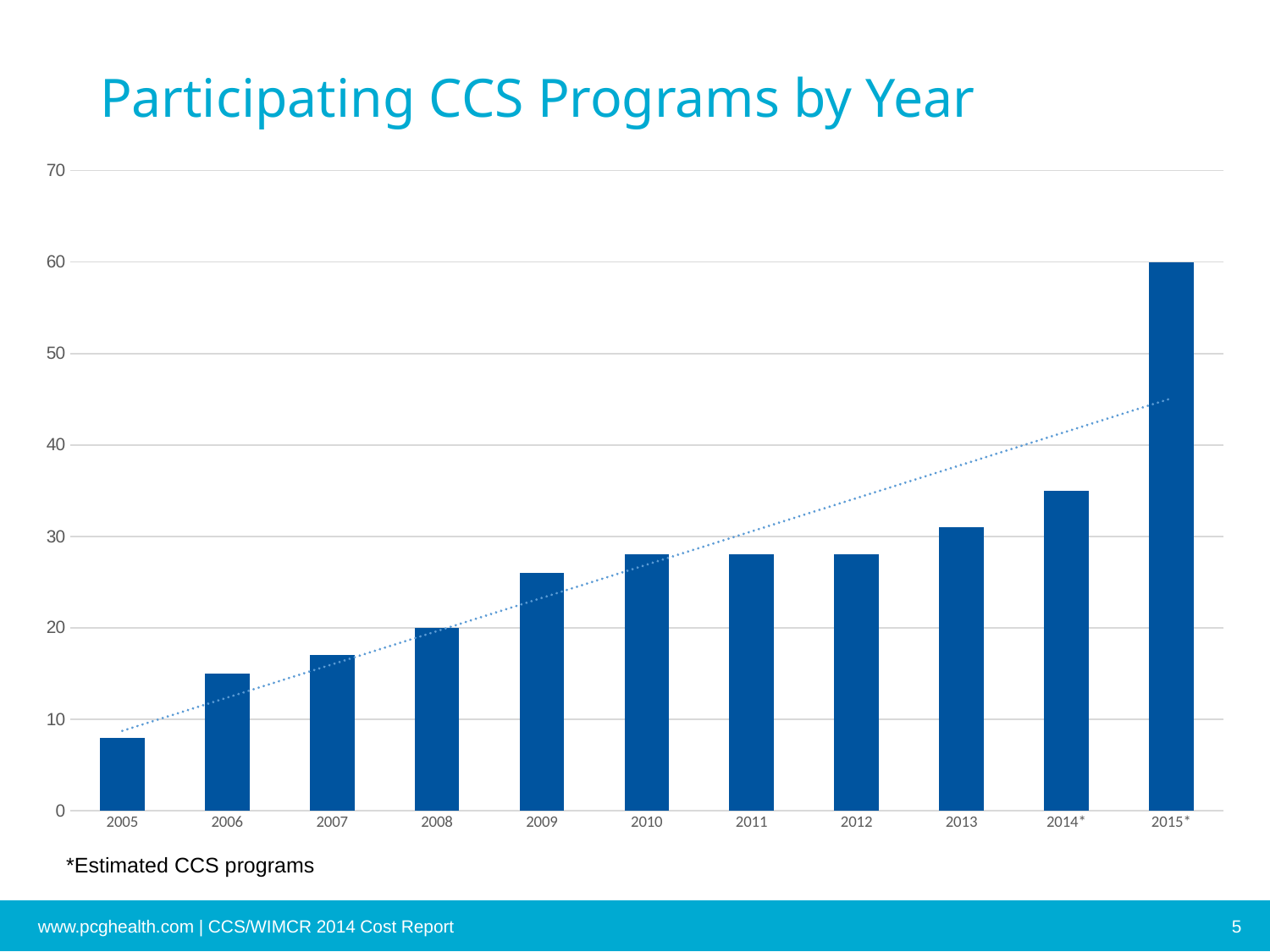
Is the value for 2014* greater or less than 30? greater What is the value for 2015*? 60 Which year has the lowest number of participating CCS programs? 2005 What is the value for 2008? 20 Is the value for 2005 greater or less than 10? less Which year has the highest number of participating CCS programs? 2015* Which year has a larger value, 2006 or 2013? 2013 Is the value for 2009 greater or less than 20? greater What kind of chart is shown on the slide? bar chart How many years are shown on the x axis of the chart? 11 What is the title of the chart? Participating CCS Programs by Year Do the values generally rise or fall from 2005 to 2015*? rise